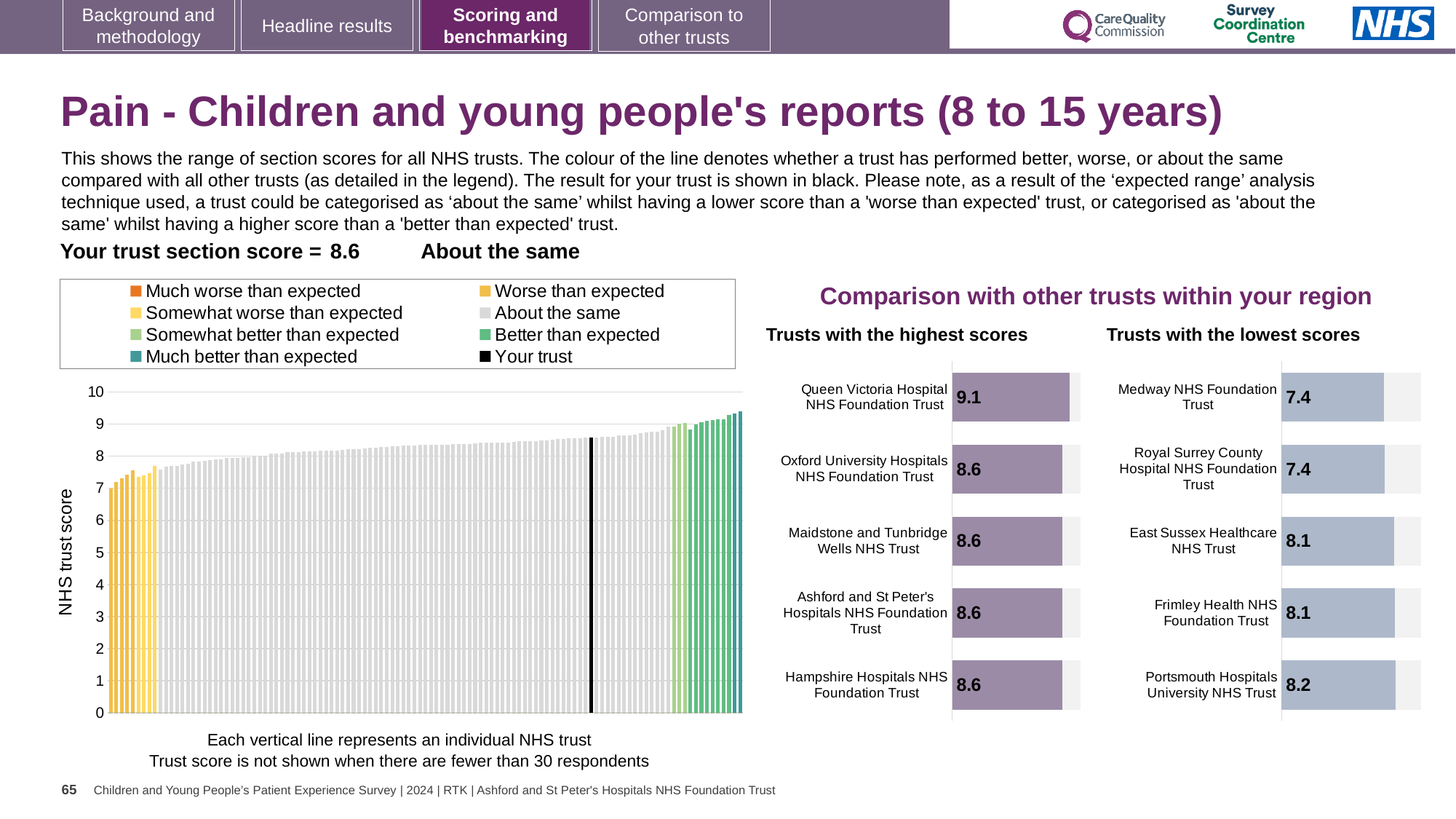
In the 'Trusts with the lowest scores' chart, which trust has the highest score? Portsmouth Hospitals University NHS Trust In the 'Trusts with the highest scores' chart, what is the difference between the score for Queen Victoria Hospital NHS Foundation Trust and the score for Oxford University Hospitals NHS Foundation Trust? 0.5 In the 'Trusts with the lowest scores' chart, what is the score for Medway NHS Foundation Trust? 7.4 In the 'Trusts with the highest scores' chart, how many trusts are shown? 5 In the 'Trusts with the lowest scores' chart, what is the difference between the score for Portsmouth Hospitals University NHS Trust and the score for Medway NHS Foundation Trust? 0.8 In the 'Trusts with the highest scores' chart, which trust has the highest score? Queen Victoria Hospital NHS Foundation Trust In the large chart on the left showing NHS trust scores, what kind of chart is it? Bar chart In the 'Trusts with the lowest scores' chart, which is larger: the score for East Sussex Healthcare NHS Trust or the score for Royal Surrey County Hospital NHS Foundation Trust? East Sussex Healthcare NHS Trust In the large chart on the left showing NHS trust scores, do the values rise or fall from left to right? Rise In the large chart on the left showing NHS trust scores, how many entries does the legend list? 8 In the 'Trusts with the lowest scores' chart, what is the score for Portsmouth Hospitals University NHS Trust? 8.2 In the 'Trusts with the highest scores' chart, what is the score for Queen Victoria Hospital NHS Foundation Trust? 9.1